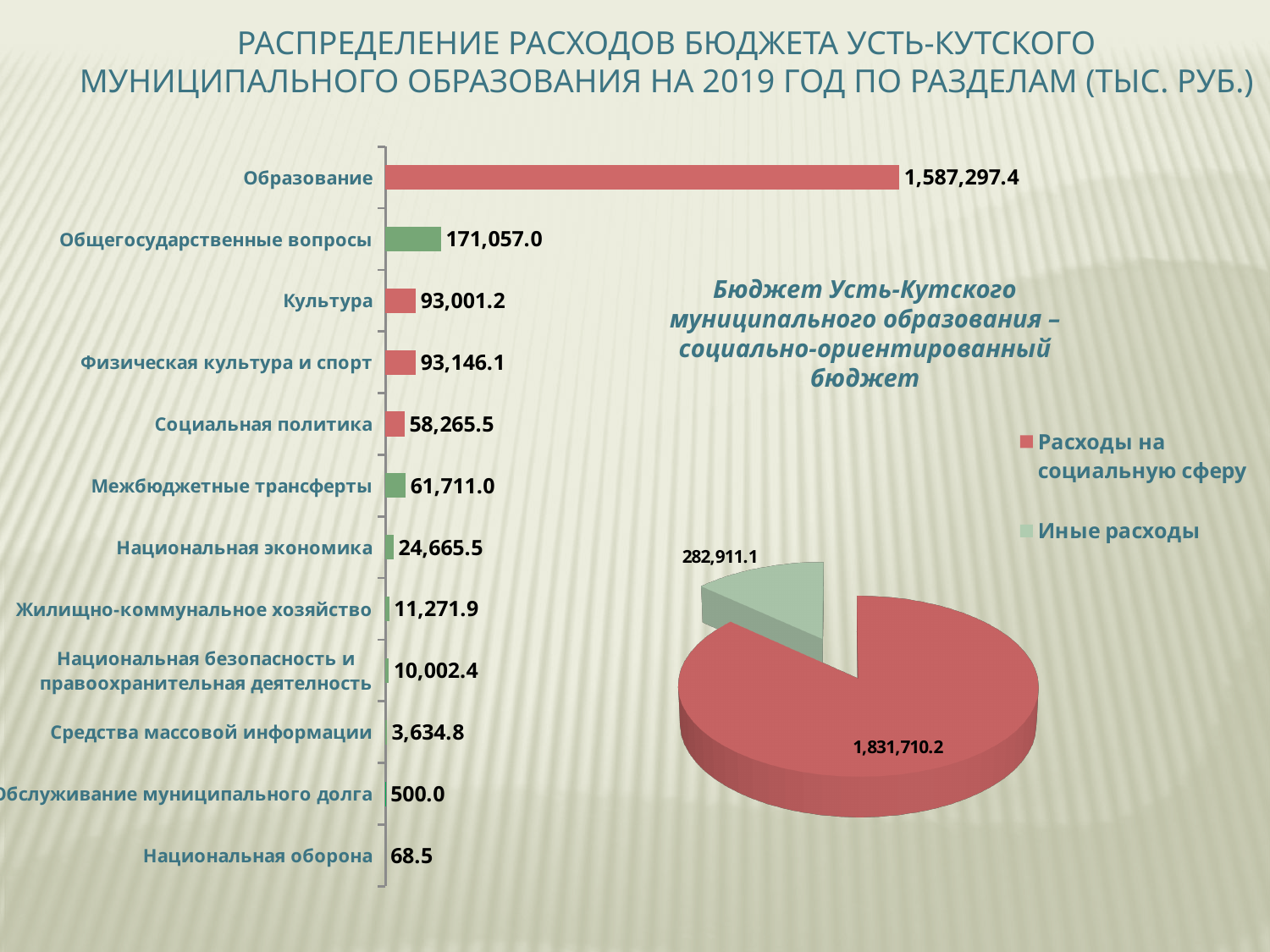
How many categories does the bar chart show? 12 On the bar chart, what is the value for Обслуживание муниципального долга? 500.0 On the bar chart, what is the difference between Образование and Общегосударственные вопросы? 1,416,240.4 On the bar chart, which category has the highest value? Образование How many entries does the pie chart's legend list? 2 On the bar chart, which category has the lowest value? Национальная оборона On the bar chart, what is the value for Образование? 1,587,297.4 On the bar chart, what is the value for Национальная экономика? 24,665.5 What type of chart is on the left side of the slide? Bar chart On the pie chart, what is the total of the two slices? 2,114,621.3 On the bar chart, which is larger: Общегосударственные вопросы or Культура? Общегосударственные вопросы On the pie chart, what is the value for Иные расходы? 282,911.1